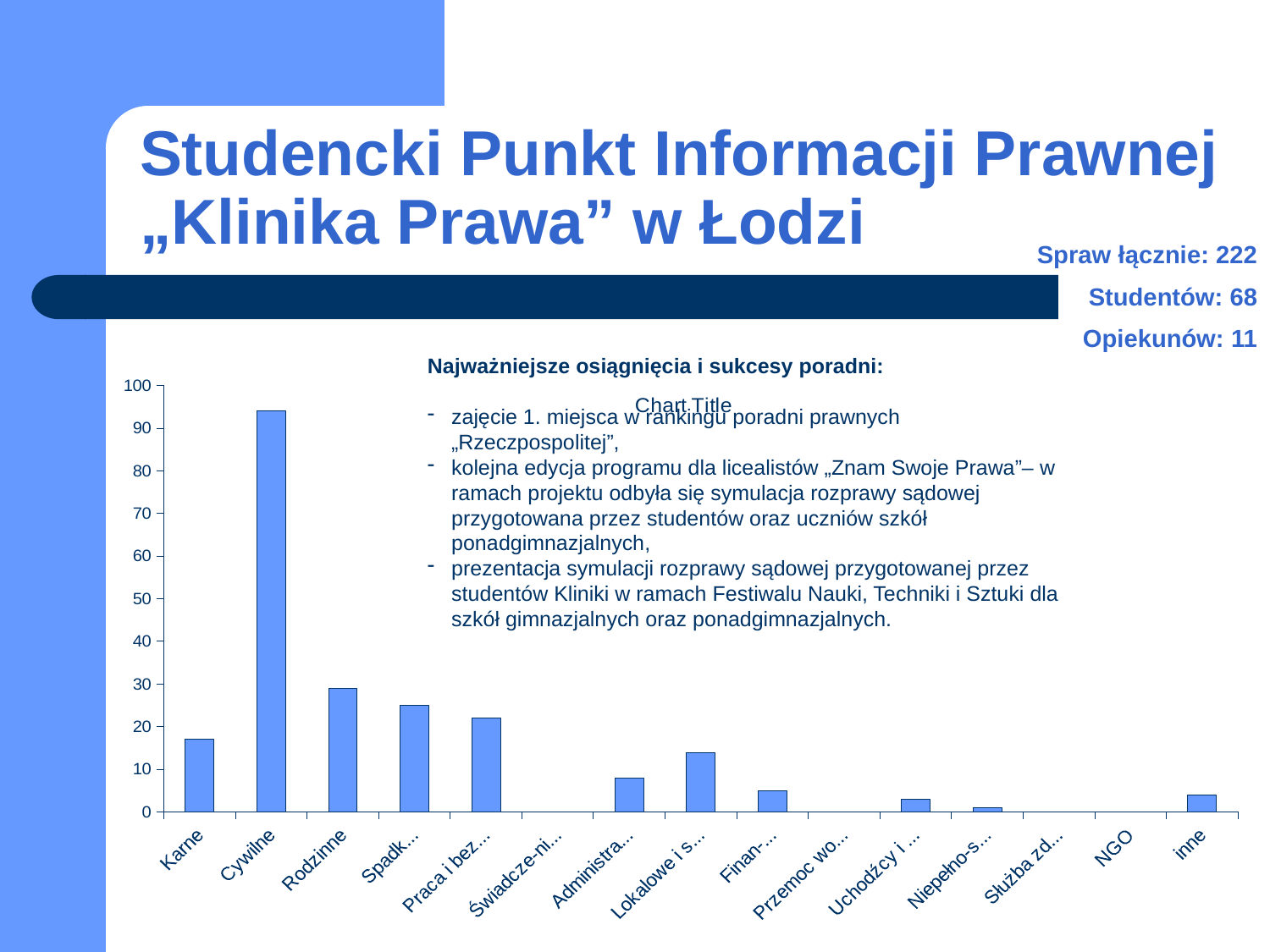
What is the title shown on the chart? Chart Title How many categories are shown on the x axis of the chart? 15 Is the value for Administra... greater or less than 10? less What kind of chart is shown on the slide? bar chart Which is larger, the value for Cywilne or the value for Karne? Cywilne Is the value for Rodzinne greater or less than 20? greater Is the value for Lokalowe i s... greater or less than 10? greater Which category has the highest bar in the chart? Cywilne Which is larger, the value for Rodzinne or the value for Karne? Rodzinne Which is larger, the value for Karne or the value for Lokalowe i s...? Karne